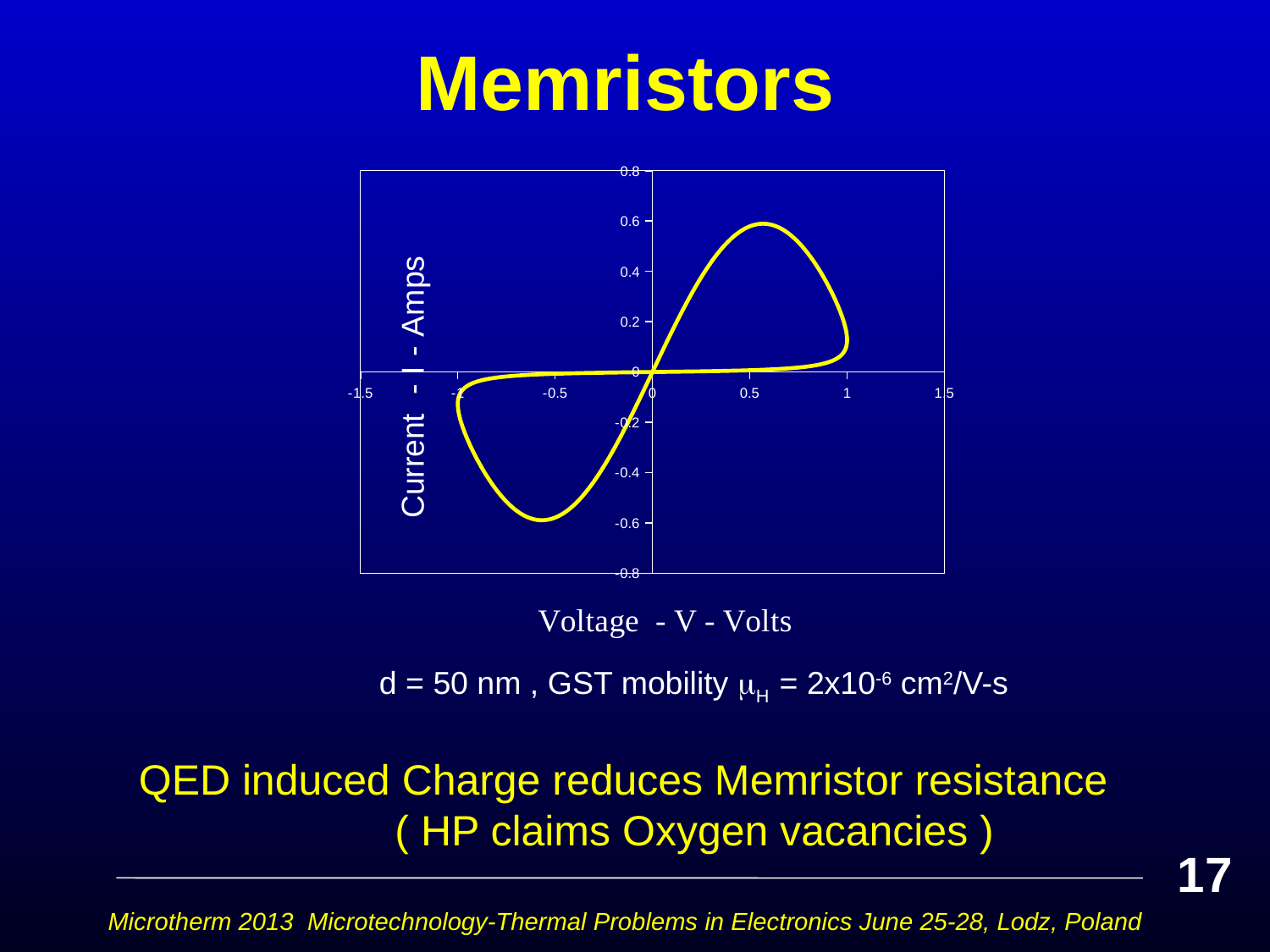
Which is larger in magnitude: the peak current at positive voltage or the current at 0 Volts? the peak current at positive voltage What is the label of the horizontal axis of the chart? Voltage - V - Volts How many curves are plotted on the chart? 1 Is the peak current at positive voltage greater or less than 0.8 Amps? less Is the peak current reached at positive voltage greater or less than 0.4 Amps? greater Is the largest voltage reached by the curve greater or less than 1.5 Volts? less What kind of chart is shown on the slide? line chart What is the label of the vertical axis of the chart? Current - I - Amps